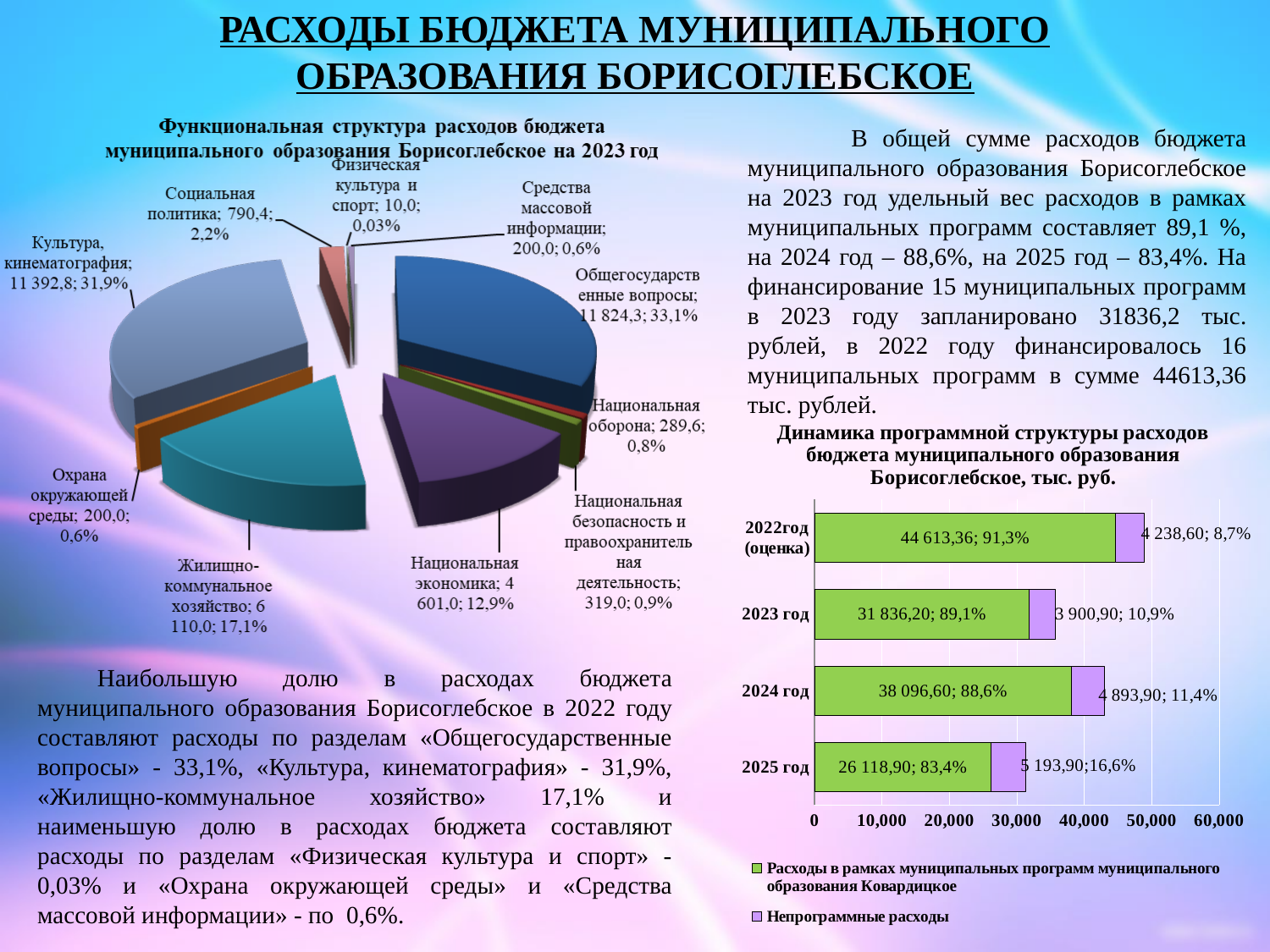
In the bar chart on the right, what is the value of 'Непрограммные расходы' for 2025 год? 5 193,90 In the pie chart on the left, which is larger: 'Национальная экономика' or 'Социальная политика'? Национальная экономика What type of chart is the chart on the right, 'Динамика программной структуры расходов бюджета муниципального образования Борисоглебское, тыс. руб.'? Stacked bar chart In the pie chart on the left, which category has the smallest share? Физическая культура и спорт How many categories are shown in the pie chart on the left? 10 In the pie chart on the left, what value is shown for 'Жилищно-коммунальное хозяйство'? 6 110,0 In the bar chart on the right, what is the value of program expenditures for 2022год (оценка)? 44 613,36 How many series does the legend of the bar chart on the right list? 2 In the bar chart on the right, what is the difference between program expenditures in 2024 год and 2023 год? 6 260,40 In the pie chart on the left, which category has the largest share? Общегосударственные вопросы In the pie chart 'Функциональная структура расходов бюджета муниципального образования Борисоглебское на 2023 год', what share is shown for 'Общегосударственные вопросы'? 33,1% In the bar chart on the right, what is the total of the stacked bar for 2023 год? 35 737,10